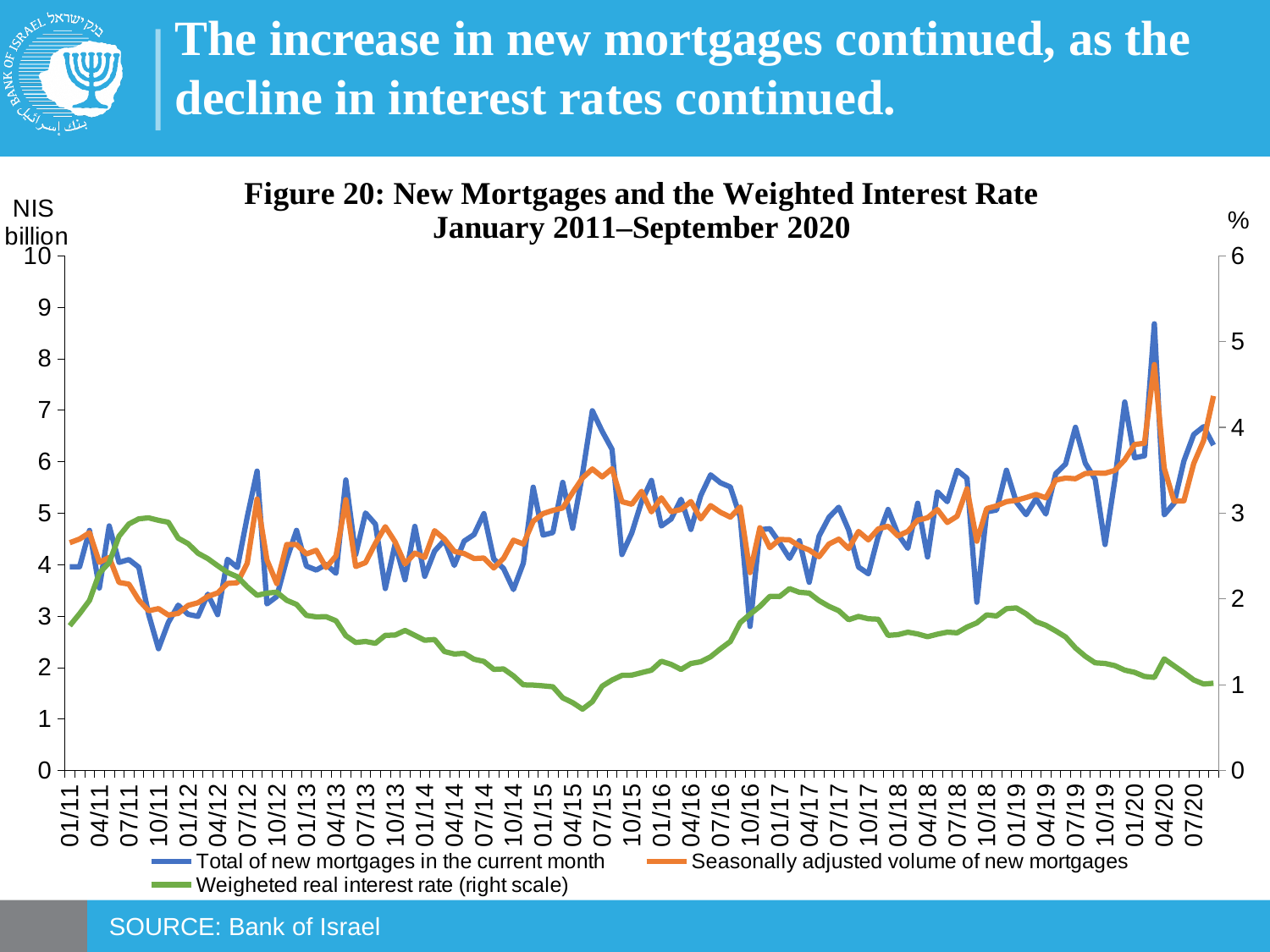
Does the weighted real interest rate rise or fall between 01/19 and 09/20? Fall Is the lowest value of the total of new mortgages in the current month (around 10/11) greater or less than 3 NIS billion? less Is the weighted real interest rate around 04/15 greater or less than 1%? less Which series reaches a higher peak in 2020, the total of new mortgages in the current month or the seasonally adjusted volume of new mortgages? Total of new mortgages in the current month In which year does the total of new mortgages in the current month reach its highest peak? 2020 Is the weighted real interest rate at 01/11 greater or less than 2%? less What kind of chart is shown in Figure 20? Line chart What unit is shown on the left axis of Figure 20? NIS billion How many series does the legend of Figure 20 list? 3 Which series in Figure 20 is plotted on the right scale? Weighted real interest rate